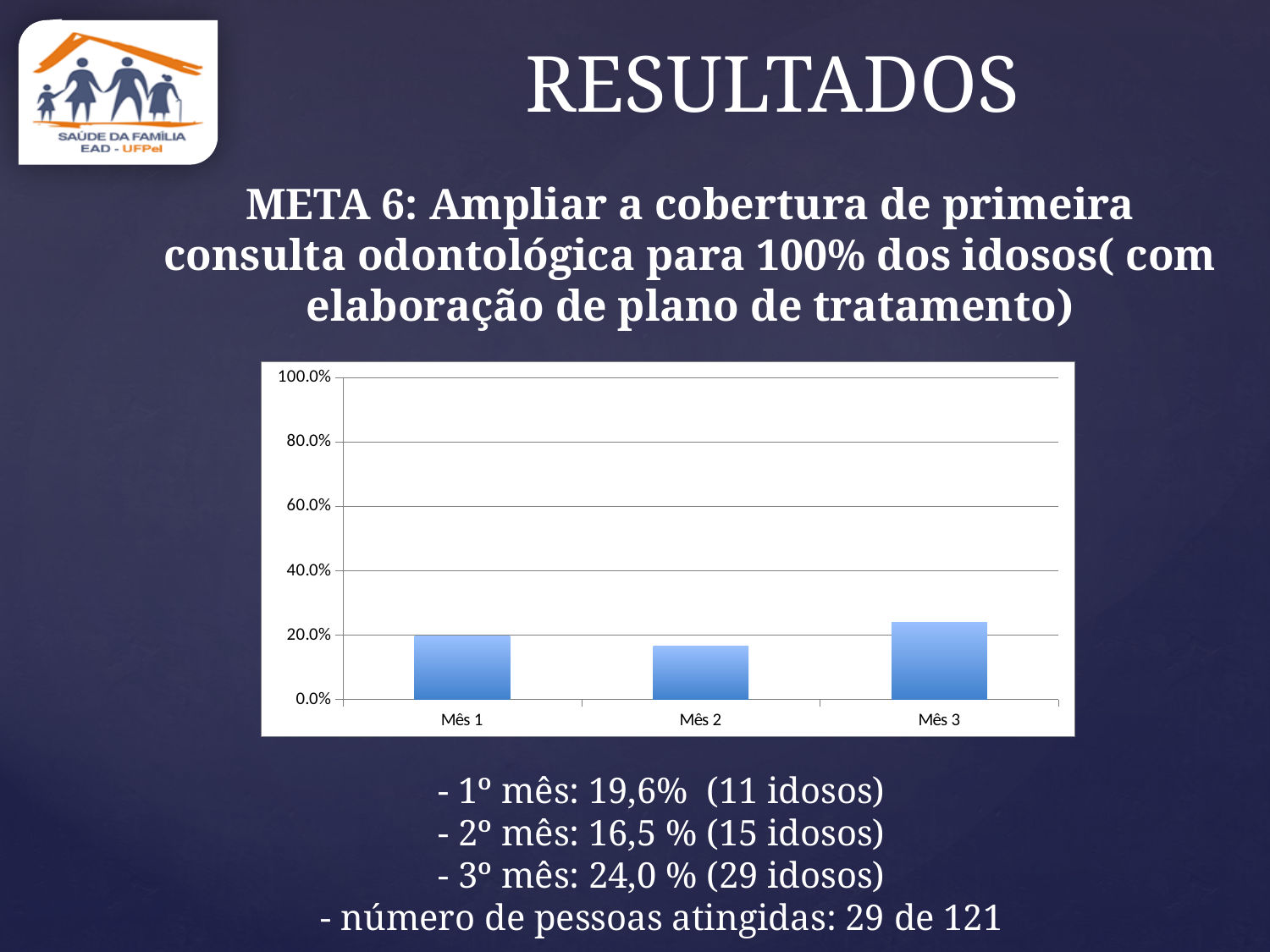
Is the value for Mês 2 greater or less than 20.0%? less Is the value for Mês 1 greater or less than 40.0%? less Which is larger, the bar for Mês 1 or the bar for Mês 2? Mês 1 What kind of chart is shown on the slide? bar chart Do the bar values rise steadily from Mês 1 to Mês 3? No, they fall from Mês 1 to Mês 2 and then rise in Mês 3 Which month has the highest bar on the chart? Mês 3 Is the value for Mês 3 greater or less than 20.0%? greater According to the text below the chart, what was the coverage in the 3º mês? 24,0 % According to the text below the chart, what was the coverage in the 1º mês? 19,6% Which month has the lowest bar on the chart? Mês 2 How many categories (months) are plotted on the chart? 3 Which is larger, the bar for Mês 3 or the bar for Mês 1? Mês 3